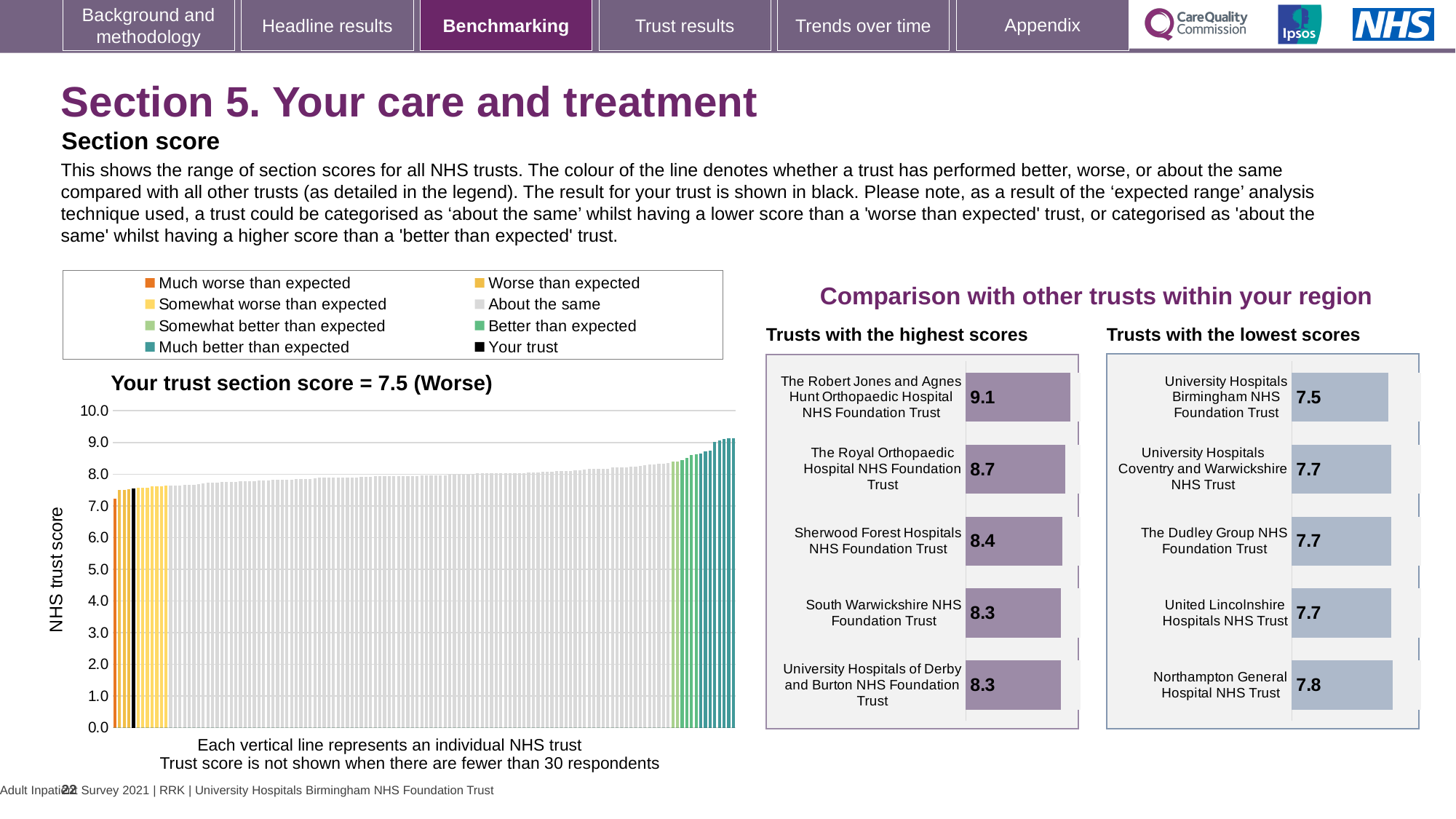
On the 'Trusts with the lowest scores' chart, which trust has the lowest score? University Hospitals Birmingham NHS Foundation Trust How many trusts are shown on the 'Trusts with the lowest scores' chart? 5 What is the y-axis label on the 'Your trust section score' chart? NHS trust score On the 'Trusts with the highest scores' chart, which trust has the highest score? The Robert Jones and Agnes Hunt Orthopaedic Hospital NHS Foundation Trust On the 'Your trust section score' chart, what is the trust's section score? 7.5 On the 'Trusts with the lowest scores' chart, which has the larger score: Northampton General Hospital NHS Trust or The Dudley Group NHS Foundation Trust? Northampton General Hospital NHS Trust On the 'Trusts with the highest scores' chart, what is the difference between the scores of The Robert Jones and Agnes Hunt Orthopaedic Hospital NHS Foundation Trust and Sherwood Forest Hospitals NHS Foundation Trust? 0.7 On the 'Your trust section score' chart, do the bars rise or fall from left to right along the x axis? rise On the 'Trusts with the highest scores' chart, what is the score for The Royal Orthopaedic Hospital NHS Foundation Trust? 8.7 How many entries does the legend above the 'Your trust section score' chart list? 8 What kind of chart is the 'Your trust section score' chart? bar chart On the 'Your trust section score' chart, is the value of the leftmost bar greater or less than 8.0? less